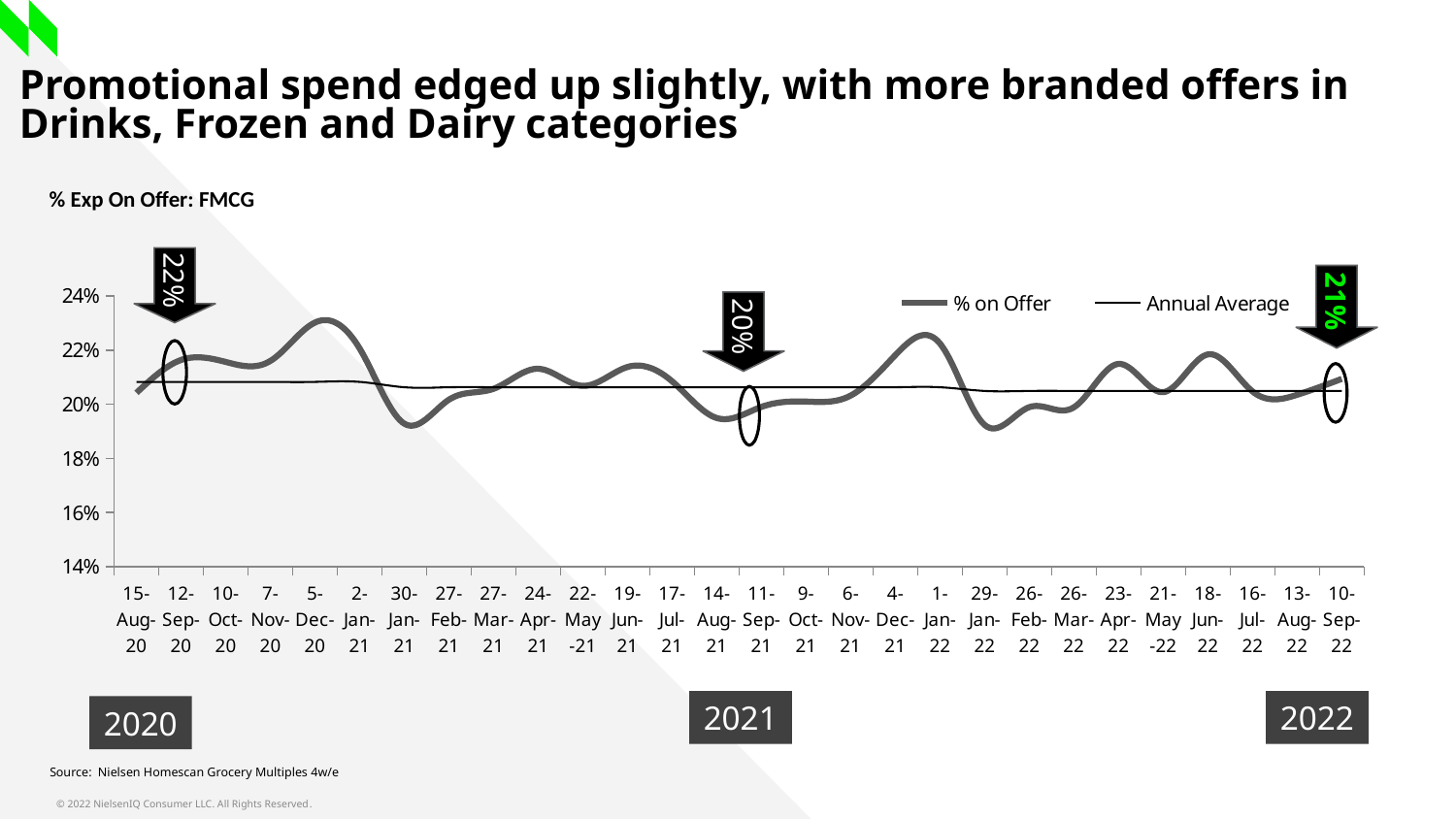
Is the % on Offer value for 5-Dec-20 greater or less than 22%? greater What is the difference between the annotated values for September 2020 (22%) and September 2021 (20%)? 2 percentage points Is the % on Offer value for 30-Jan-21 greater or less than 20%? less How many series does the chart legend list? 2 What annotated % on Offer value is shown for the circled point in September 2022? 21% Which annotated value is larger: September 2020 or September 2022? September 2020 What annotated % on Offer value is shown for the circled point in September 2020? 22% What are the two series named in the chart legend? % on Offer and Annual Average What kind of chart is shown on the slide? Line chart What is the title of the chart? % Exp On Offer: FMCG What annotated % on Offer value is shown for the circled point in September 2021? 20% How many dated periods are labelled on the x axis? 28